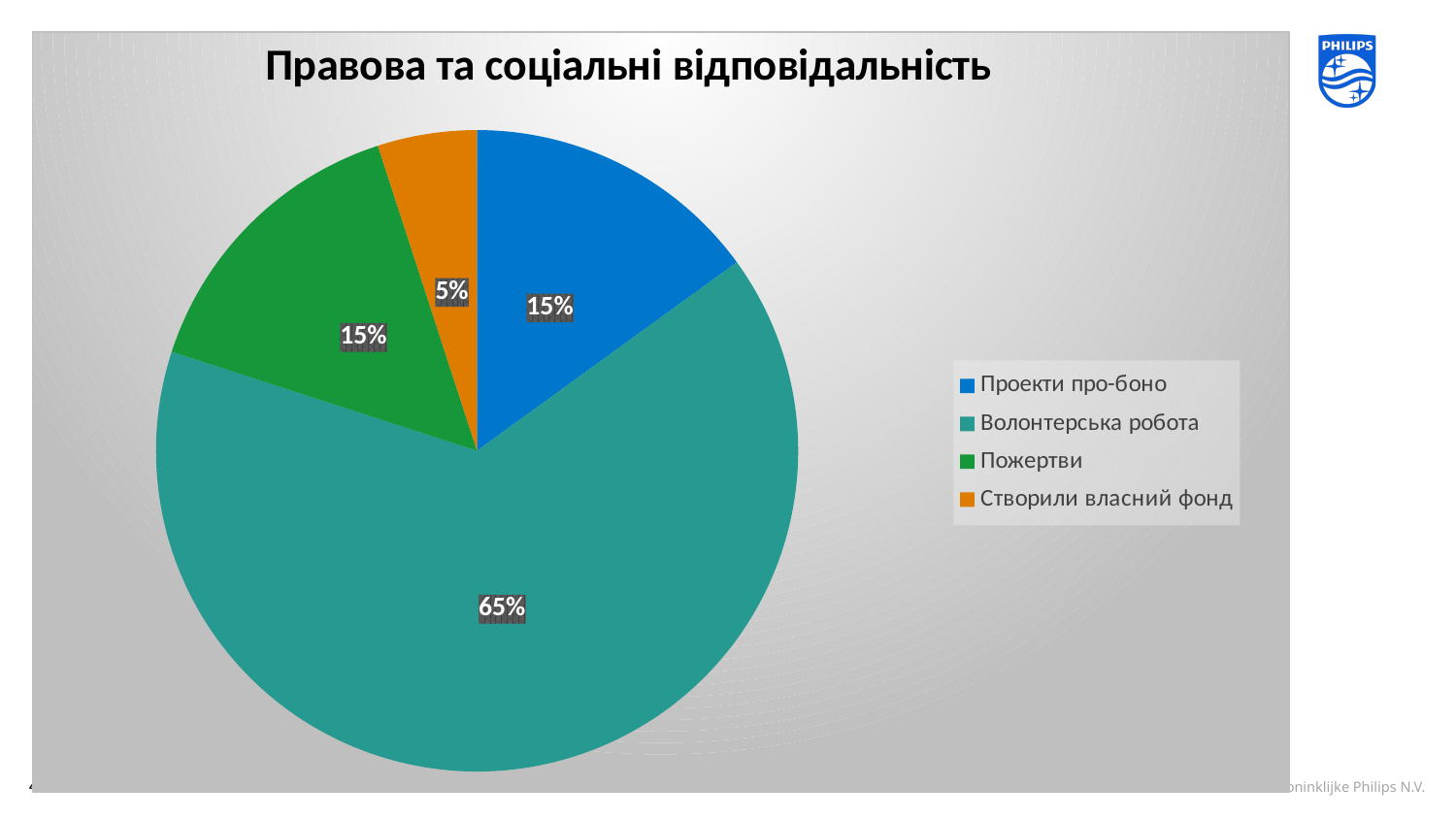
What is the value shown for Створили власний фонд? 5% What colour is the slice for Створили власний фонд? orange Which category has the largest slice of the pie? Волонтерська робота Which category has the smallest slice of the pie? Створили власний фонд What share of the pie does Волонтерська робота take? 65% What is the title of the chart? Правова та соціальні відповідальність What is the value shown for Проекти про-боно? 15% Which is larger, the share for Проекти про-боно or the share for Створили власний фонд? Проекти про-боно How many categories does the pie chart have? 4 What is the value shown for Пожертви? 15% What kind of chart is shown on the slide? pie chart What is the difference between the shares of Волонтерська робота and Пожертви? 50%